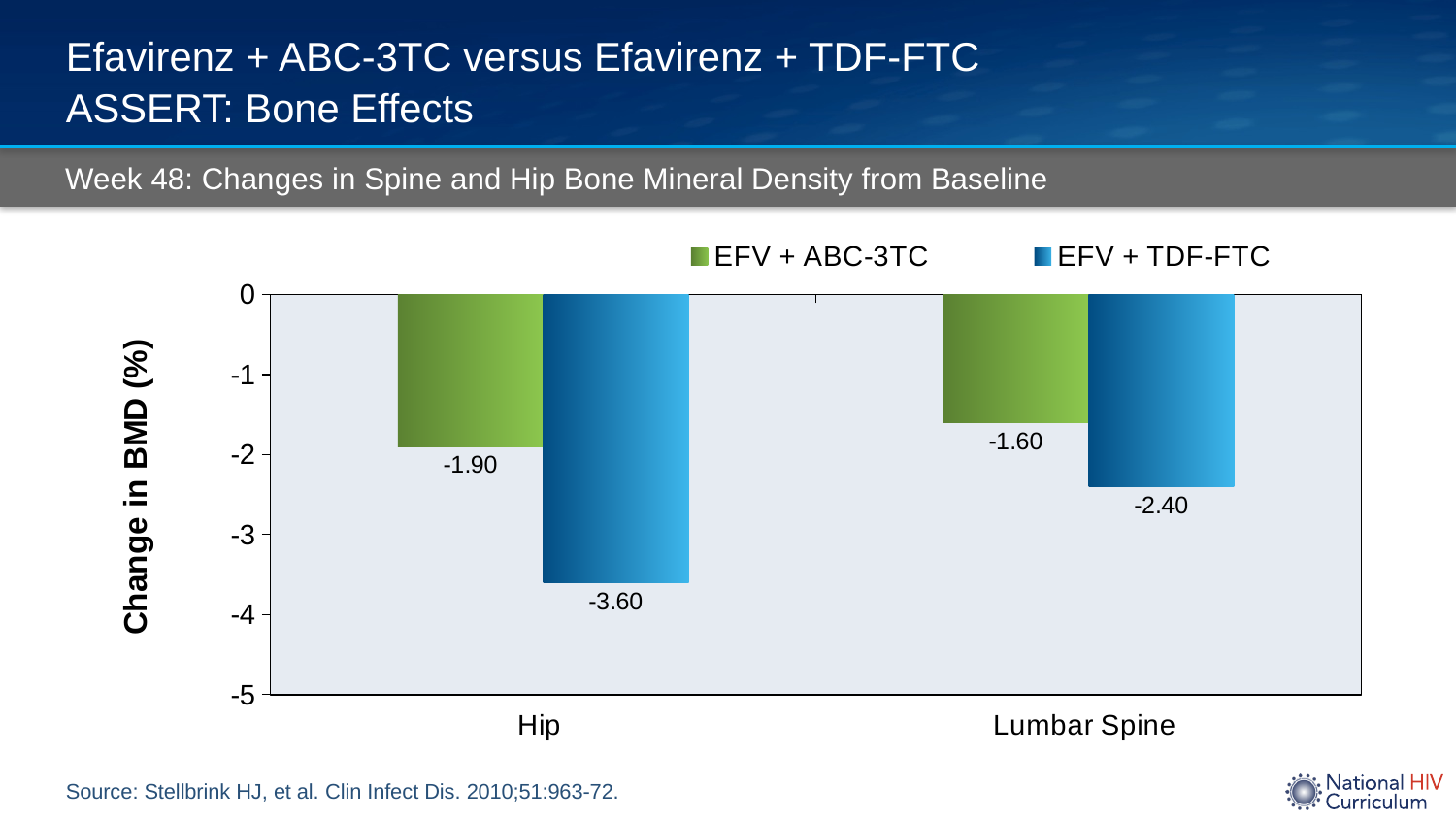
How many series does the legend list? 2 What is the change in BMD for EFV + ABC-3TC at the Hip? -1.90 How many categories are shown on the x axis? 2 What is the change in BMD for EFV + TDF-FTC at the Hip? -3.60 What is the difference between the EFV + TDF-FTC and EFV + ABC-3TC values at the Lumbar Spine? 0.80 What is the change in BMD for EFV + ABC-3TC at the Lumbar Spine? -1.60 What is the difference between the EFV + TDF-FTC and EFV + ABC-3TC values at the Hip? 1.70 What kind of chart is shown on the slide? Bar chart Which bar shows the smallest decrease in BMD? EFV + ABC-3TC at the Lumbar Spine Which treatment shows a larger decrease in BMD at the Lumbar Spine? EFV + TDF-FTC Which bar shows the largest decrease in BMD? EFV + TDF-FTC at the Hip What is the change in BMD for EFV + TDF-FTC at the Lumbar Spine? -2.40